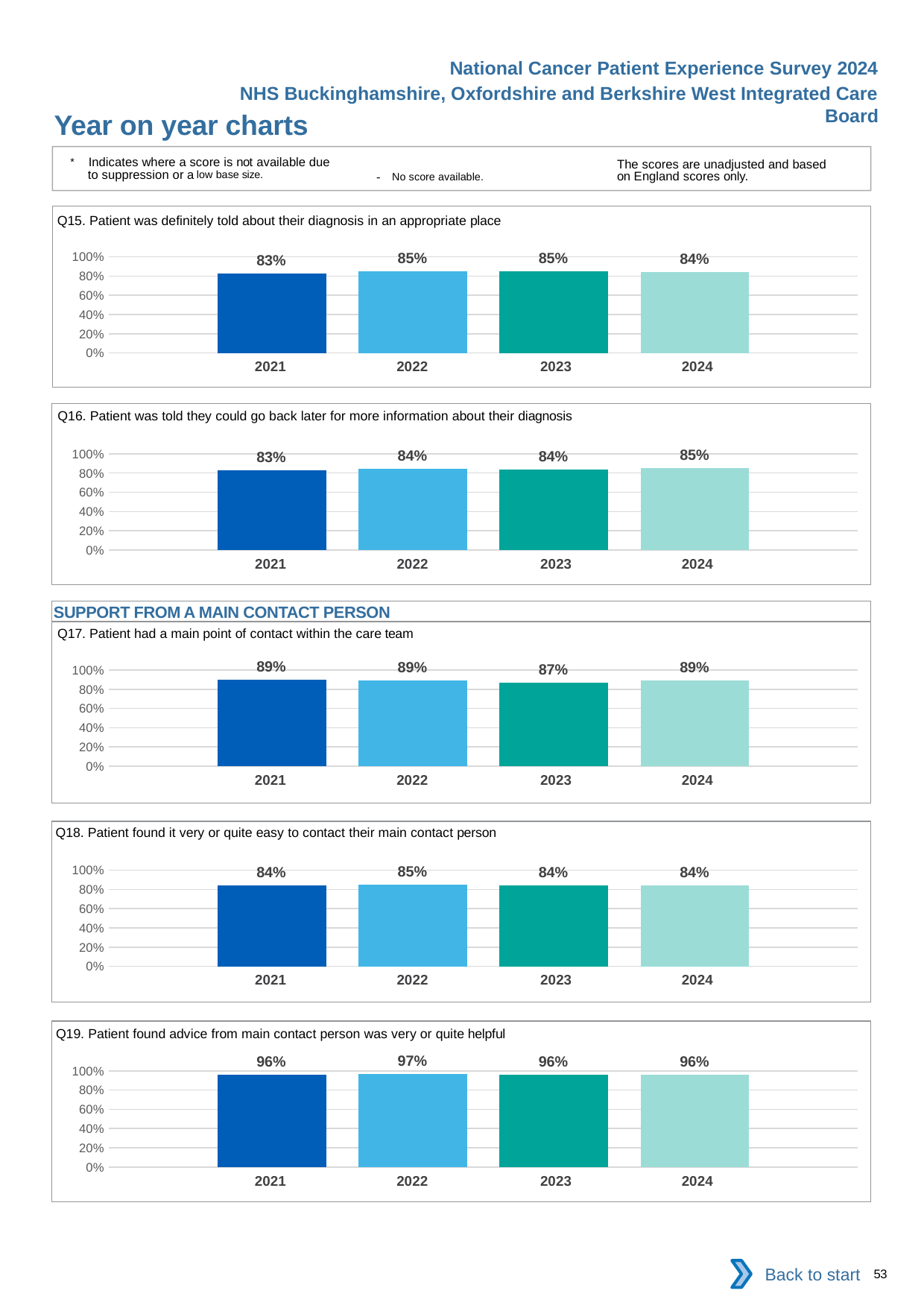
In the Q19 chart (Patient found advice from main contact person was very or quite helpful), what is the value for 2022? 97% In the Q19 chart (Patient found advice from main contact person was very or quite helpful), is the value for 2021 greater or less than 80%? greater In the Q15 chart, what is the difference between the 2022 and 2024 values? 1 percentage point What is the section heading shown above the Q17 chart? SUPPORT FROM A MAIN CONTACT PERSON In the Q16 chart (Patient was told they could go back later for more information about their diagnosis), what is the value for 2024? 85% In the Q18 chart (Patient found it very or quite easy to contact their main contact person), which year has the highest value? 2022 In the Q16 chart, is the 2021 value larger or smaller than the 2024 value? Smaller In the Q17 chart (Patient had a main point of contact within the care team), what is the difference between the 2022 and 2023 values? 2 percentage points How many years are shown on the x axis of the Q15 chart? 4 In the Q15 chart (Patient was definitely told about their diagnosis in an appropriate place), what is the value for 2021? 83% What type of chart is used for Q16 (Patient was told they could go back later for more information about their diagnosis)? Bar chart In the Q17 chart (Patient had a main point of contact within the care team), which year has the lowest value? 2023